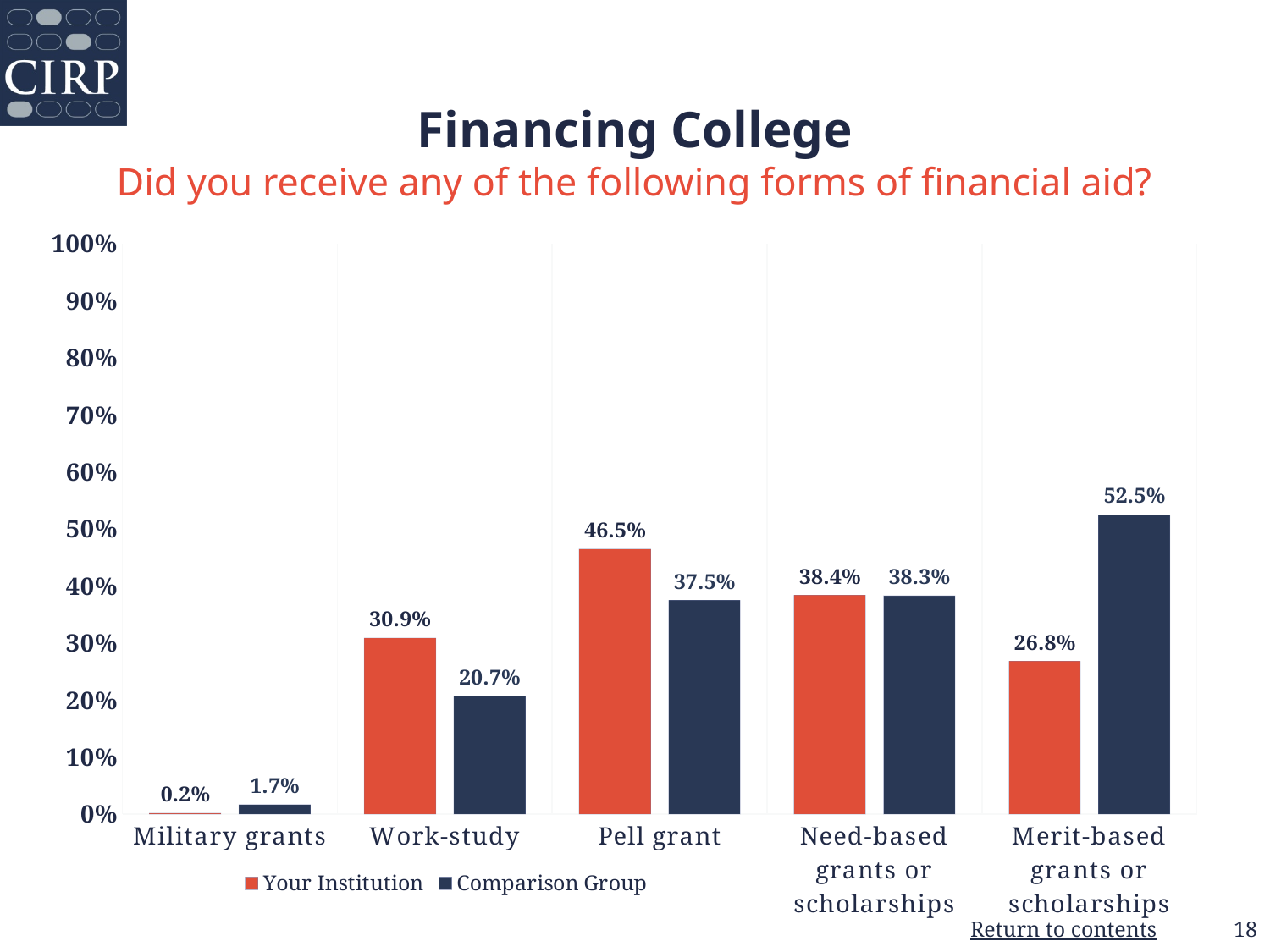
What is the title of the chart? Financing College Which category has the highest value for the Comparison Group? Merit-based grants or scholarships What percentage of Your Institution students received a Pell grant? 46.5% What is the Your Institution value for Work-study? 30.9% For Work-study, which is larger: Your Institution or the Comparison Group? Your Institution Which category has the lowest value for Your Institution? Military grants What is the Comparison Group value for Merit-based grants or scholarships? 52.5% What is the difference between the Comparison Group and Your Institution for Merit-based grants or scholarships? 25.7% How many series does the legend list? 2 How many categories of financial aid are shown on the x axis? 5 What is the difference between Your Institution and the Comparison Group for Pell grant? 9.0% What kind of chart is shown on the slide? Bar chart